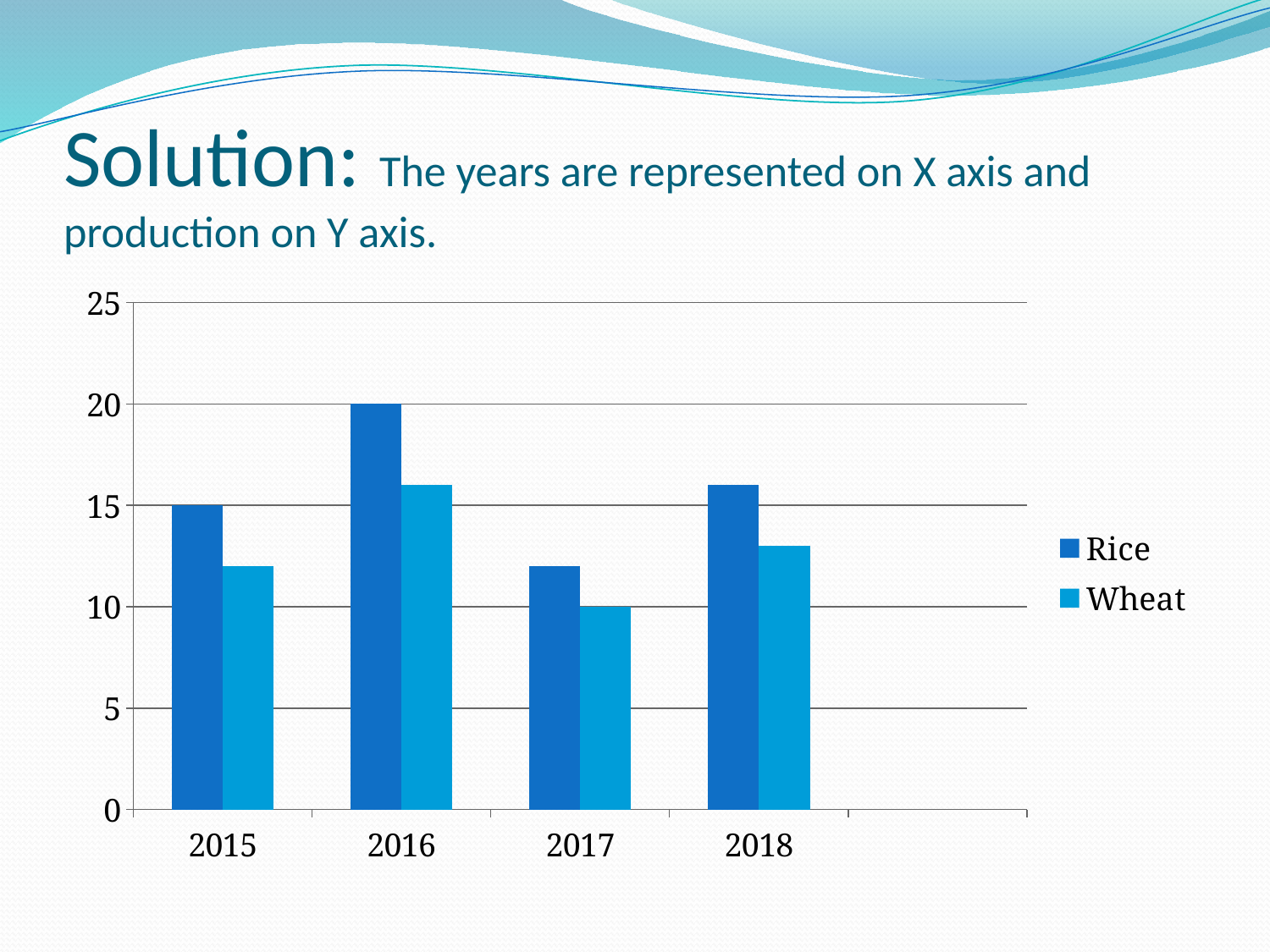
What is the difference between the Rice values for 2016 and 2015? 5 How many years are shown on the x axis? 4 What type of chart is shown on the slide? Bar chart In which year is Rice production highest? 2016 What is the Rice value for 2015? 15 What is the Wheat value for 2017? 10 In 2015, which is larger, Rice or Wheat? Rice What is the Rice value for 2016? 20 Does Rice production rise or fall from 2016 to 2017? fall How many series does the legend list? 2 Is the Wheat value for 2015 greater or less than 10? greater In which year is Wheat production lowest? 2017